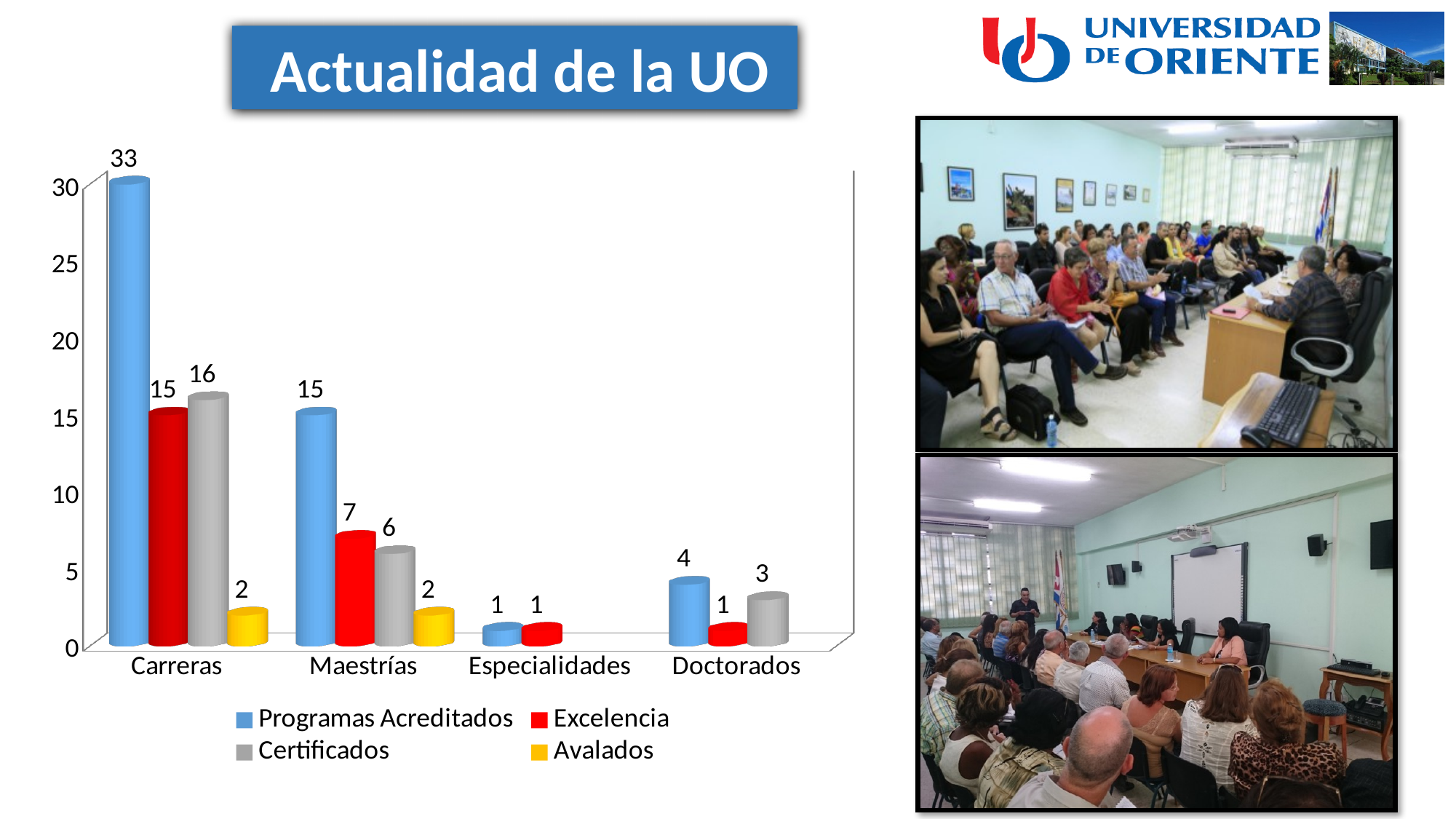
What kind of chart is shown on the slide? Bar chart What is the value of Certificados for Maestrías? 6 Is the value of Programas Acreditados for Maestrías greater or less than 10? greater Which colour represents the Avalados series? Yellow Which category has the lowest value for Excelencia? Especialidades and Doctorados (both 1) How many categories are shown on the x axis? 4 For Carreras, which is larger: Excelencia or Certificados? Certificados What is the value of Excelencia for Doctorados? 1 What is the value of Programas Acreditados for Carreras? 33 How many series does the legend list? 4 Which category has the highest value for Programas Acreditados? Carreras What is the difference between Programas Acreditados and Excelencia for Carreras? 18